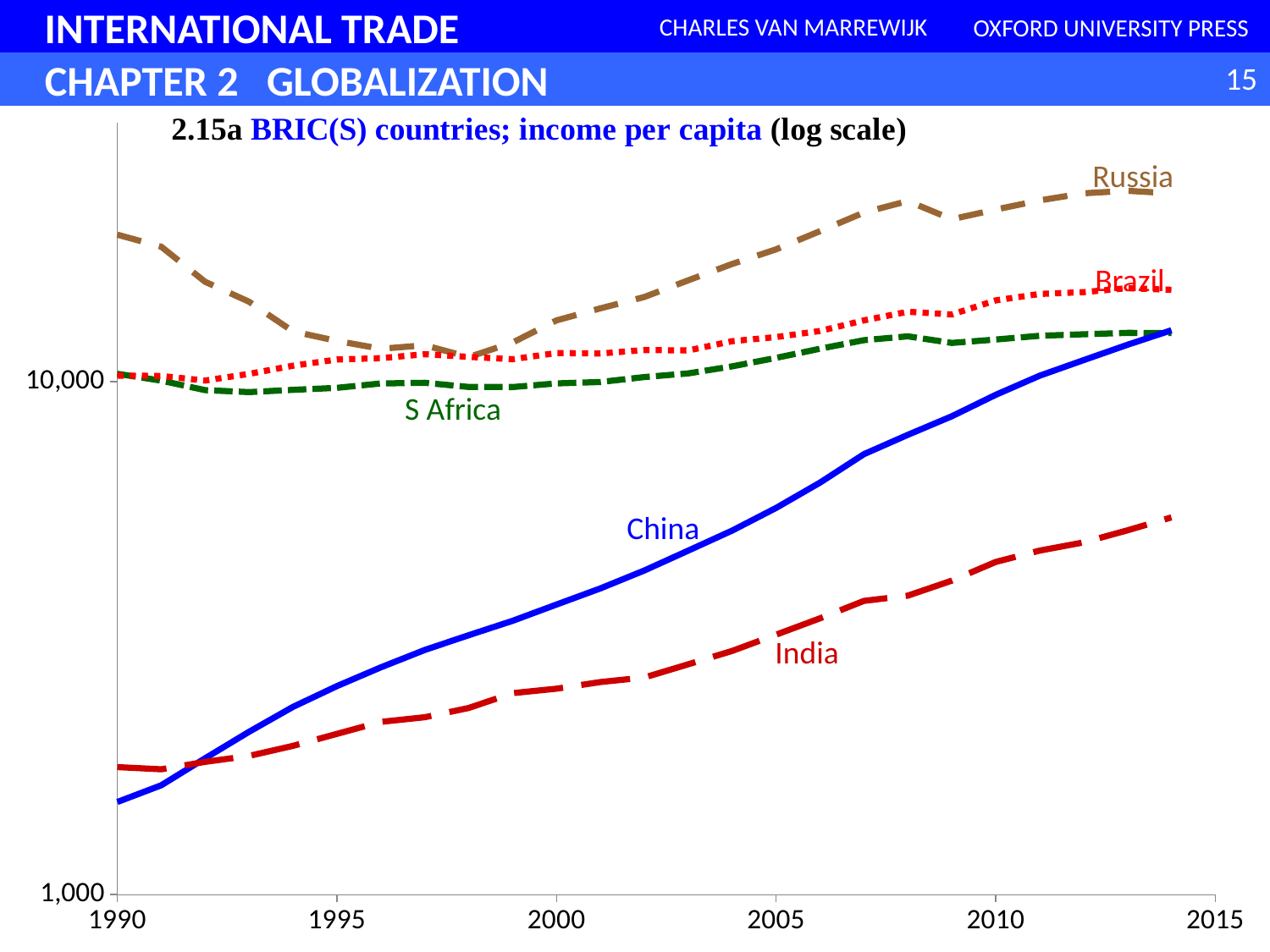
In 2014, which has the higher income per capita, Russia or Brazil? Russia In 2014, which has the higher income per capita, China or India? China Is the value for India in 2014 greater or less than 10,000? less Is the value for China in 1990 greater or less than 10,000? less What kind of chart is shown on the slide? line chart What is the title of the chart? 2.15a BRIC(S) countries; income per capita (log scale) Which country has the lowest income per capita in 2014? India Which country has the highest income per capita in 2014? Russia Is the value for Russia in 2014 greater or less than 10,000? greater Which country has the lowest income per capita in 1990? China How many countries are plotted on the chart? 5 Does the line for China rise or fall from 1990 to 2014? rise